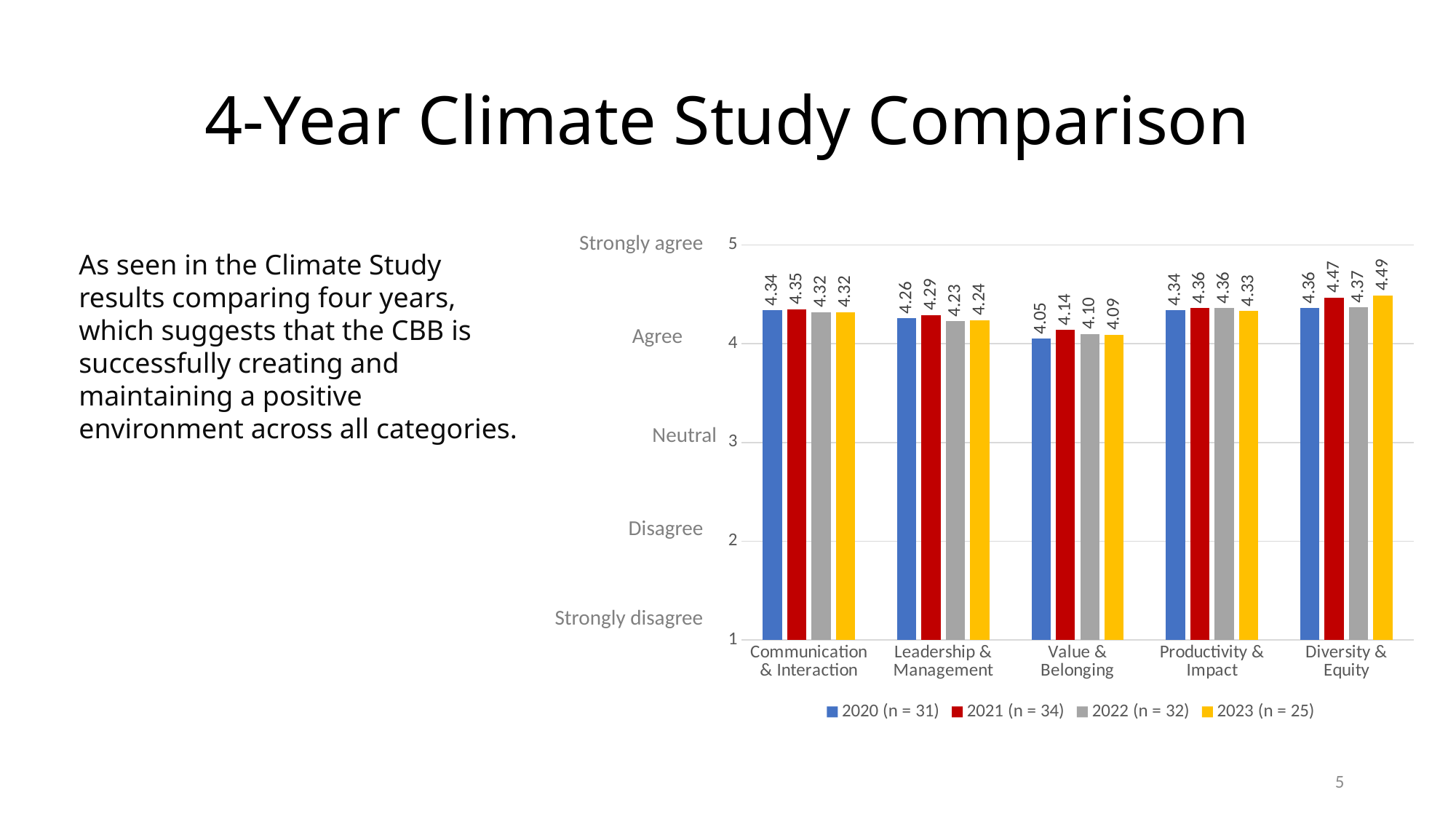
What is the value for Diversity & Equity in the 2023 (n = 25) series? 4.49 What kind of chart is shown on the slide? bar chart Which category has the highest value in the 2023 (n = 25) series? Diversity & Equity How many categories are shown on the x axis? 5 What is the value for Value & Belonging in the 2021 (n = 34) series? 4.14 Is the value for Value & Belonging in the 2020 (n = 31) series greater or less than 4? greater Which is larger for Value & Belonging: the 2021 (n = 34) value or the 2023 (n = 25) value? 2021 (n = 34) What is the value for Leadership & Management in the 2022 (n = 32) series? 4.23 How many series does the legend list? 4 What is the value for Communication & Interaction in the 2020 (n = 31) series? 4.34 Which category has the lowest value in the 2020 (n = 31) series? Value & Belonging What is the difference between the 2023 (n = 25) and 2020 (n = 31) values for Diversity & Equity? 0.13